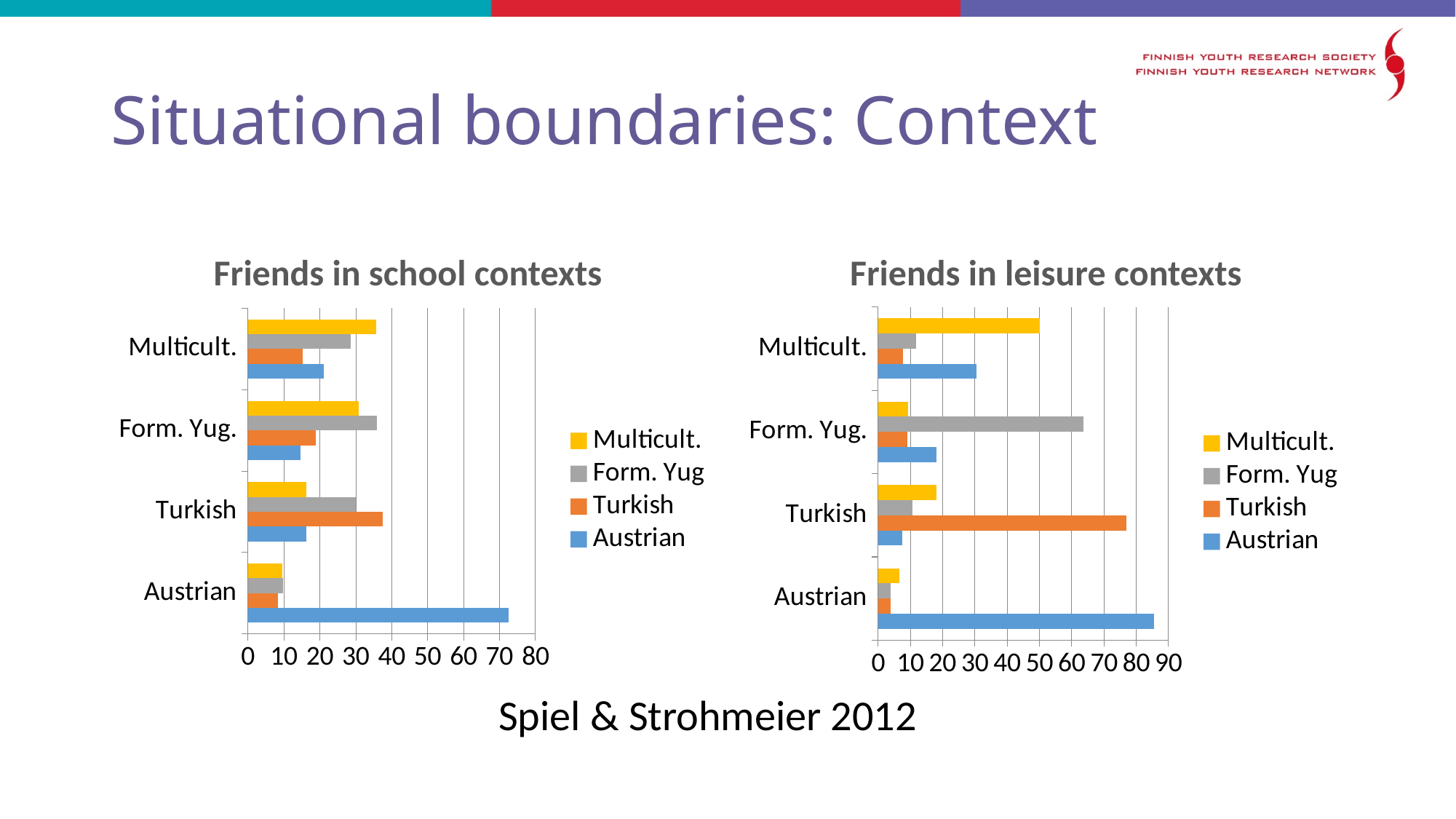
In the "Friends in school contexts" chart, is the Austrian series value for the Form. Yug. category greater or less than 20? less What type of chart is "Friends in school contexts"? bar chart How many series does the legend of the "Friends in leisure contexts" chart list? 4 In the "Friends in leisure contexts" chart, is the Austrian series value for the Austrian category greater or less than 80? greater In the "Friends in leisure contexts" chart, is the Austrian series value for the Turkish category greater or less than 10? less In the "Friends in leisure contexts" chart, for the Form. Yug. category, which series has the larger value: Form. Yug or Multicult.? Form. Yug Which colour represents the Austrian series in the "Friends in school contexts" chart? blue How many categories are shown on the y axis of the "Friends in school contexts" chart? 4 In the "Friends in school contexts" chart, which category has the longest bar overall? Austrian